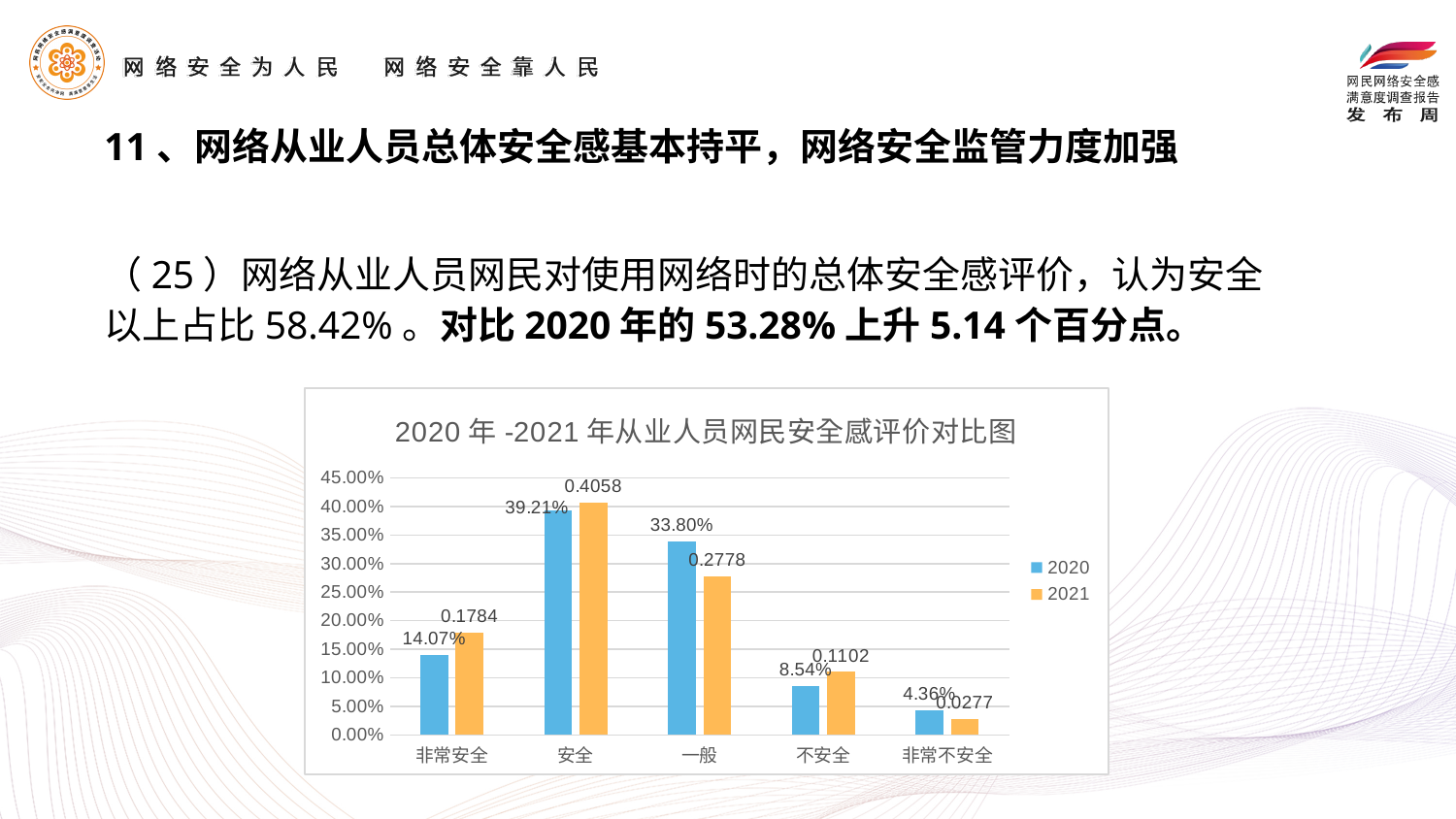
What is the 2021 value for 安全? 0.4058 What type of chart is shown on the slide? bar chart Which category has the lowest 2021 value? 非常不安全 What is the difference between the 2020 values for 安全 and 一般? 5.41% What is the title of the chart? 2020年-2021年从业人员网民安全感评价对比图 What is the 2020 value for 一般? 33.80% How many series does the chart legend list? 2 For 不安全, which series has the larger value, 2020 or 2021? 2021 What is the 2021 value for 非常不安全? 0.0277 What is the 2020 value for 非常安全? 14.07% How many categories are shown on the x axis of the chart? 5 Which category has the highest 2020 value? 安全